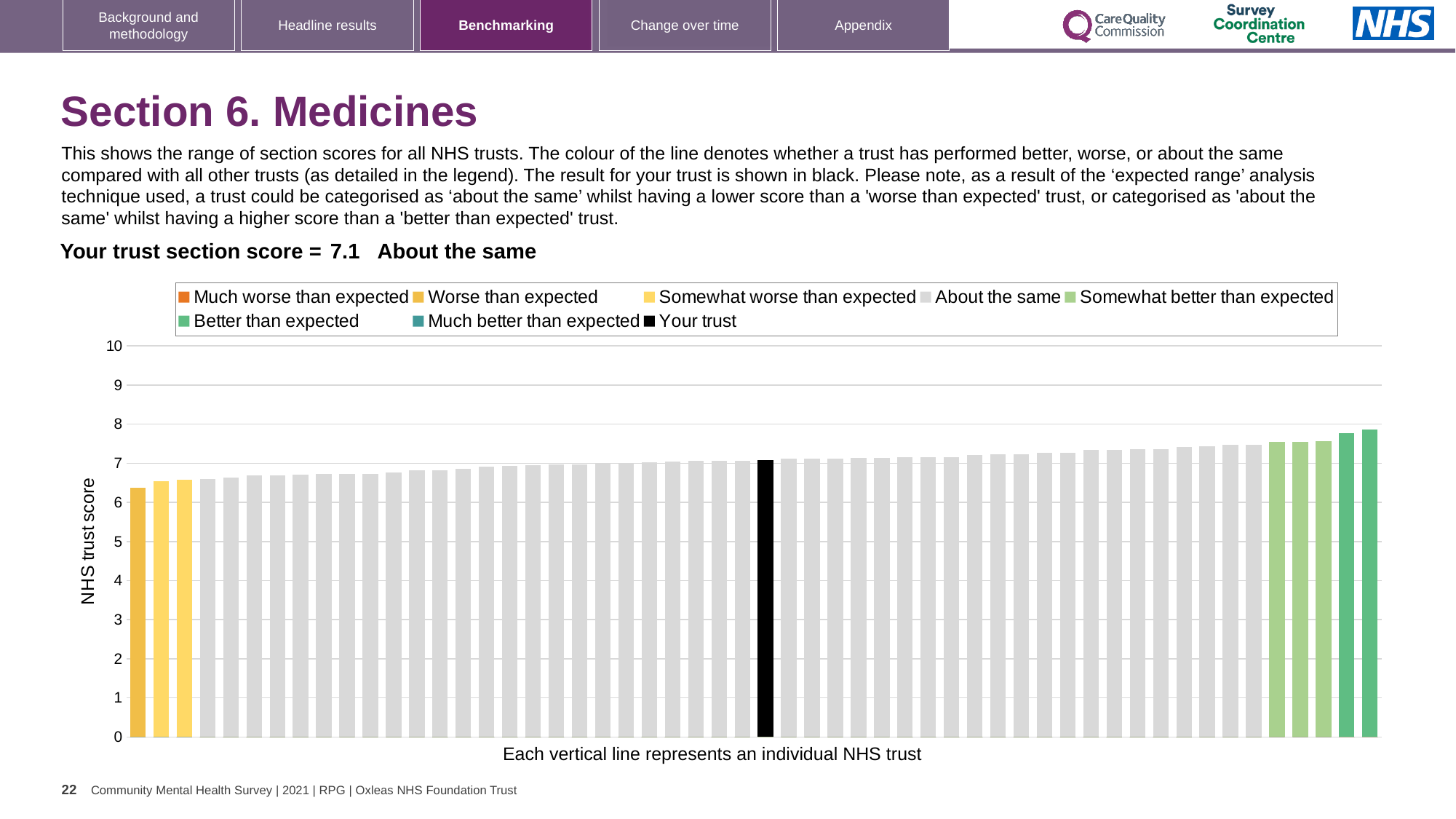
Which benchmarking category is your trust placed in for Section 6. Medicines? About the same Is the value of the leftmost (lowest) bar greater or less than 7? less Is the value of the leftmost bar greater or less than 6? greater What kind of chart is shown on the slide? bar chart Is the value of the rightmost (highest) bar greater or less than 8? less What is the section score for your trust shown on the slide? 7.1 What is the label on the vertical axis of the chart? NHS trust score How many entries does the chart legend list? 8 Which is larger, the leftmost bar or your trust's black bar? your trust's black bar Which legend category does the highest bar on the chart belong to? Better than expected Do the bar values rise or fall from left to right along the x axis? rise